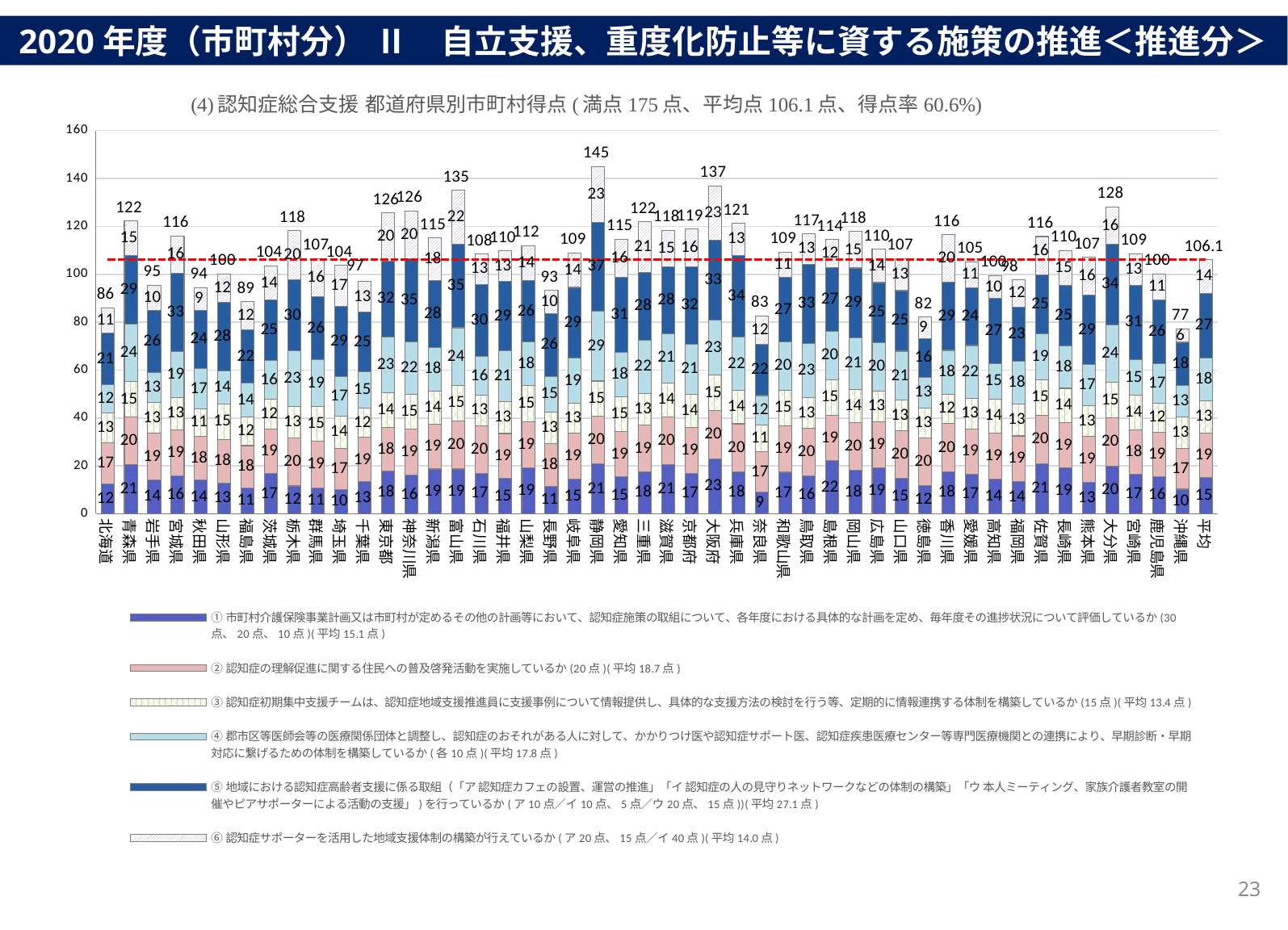
What is the difference between the total score of 静岡県 and that of 沖縄県? 68 How many series does the legend list? 6 What is the total score for 大阪府? 137 Which prefecture has the highest total score? 静岡県 Which prefecture has the lowest total score? 沖縄県 Which has a higher total score, 東京都 or 富山県? 富山県 What is the value shown for the 平均 bar? 106.1 What kind of chart is shown on the slide? Stacked bar chart Is the total score for 奈良県 greater or less than 100? less What is the value of the bottom segment (series ①) for 北海道? 12 What is the total score for 大分県? 128 According to the chart subtitle, what is the maximum possible score (満点)? 175 点